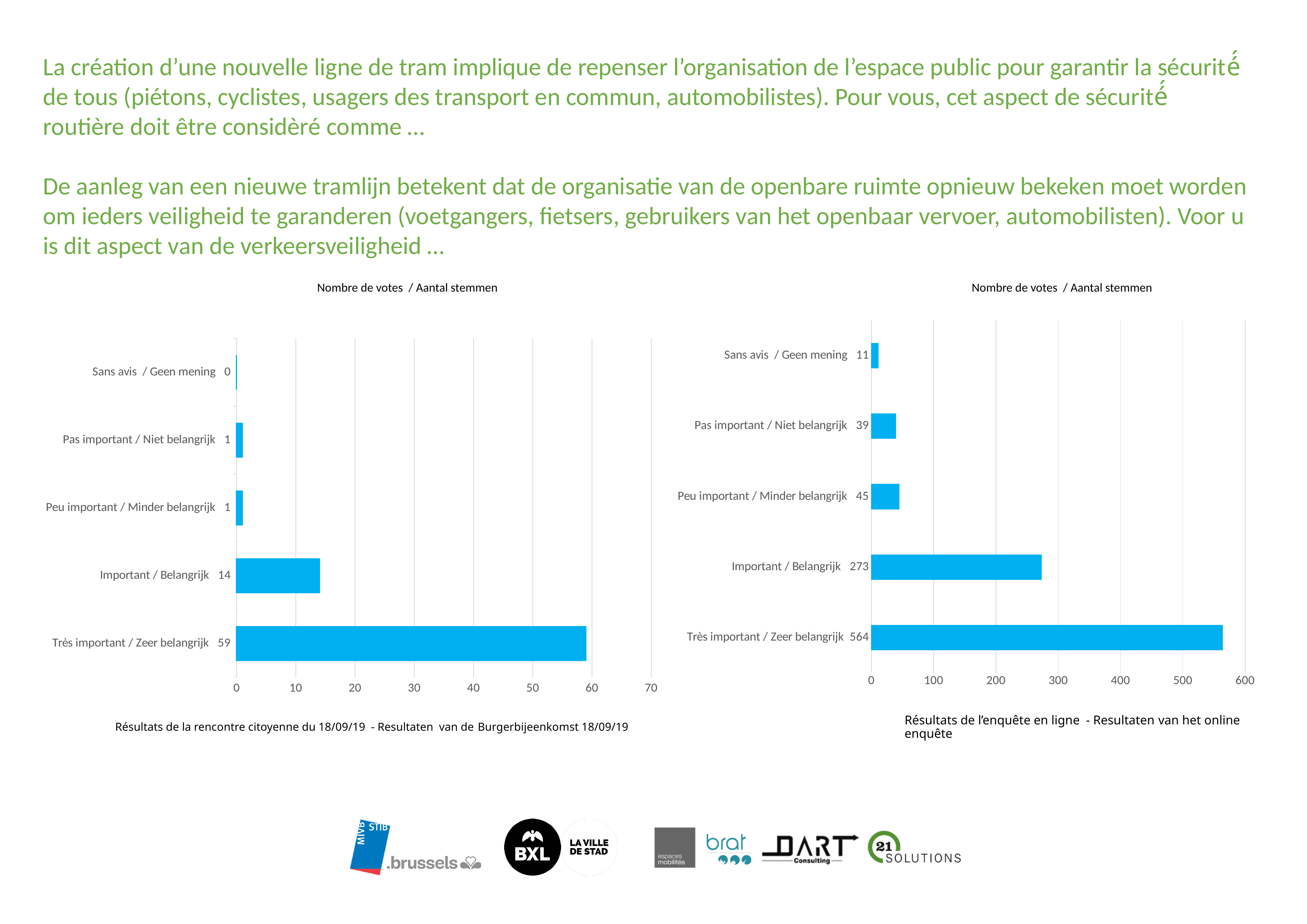
In the right chart (Résultats de l'enquête en ligne), what is the difference in votes between 'Très important / Zeer belangrijk' and 'Important / Belangrijk'? 291 In the right chart (Résultats de l'enquête en ligne), which category has the highest number of votes? Très important / Zeer belangrijk In the left chart (Résultats de la rencontre citoyenne du 18/09/19), how many categories are shown? 5 What type of chart is used on the right side of the slide (Résultats de l'enquête en ligne)? Bar chart In the right chart (Résultats de l'enquête en ligne), how many votes did 'Très important / Zeer belangrijk' receive? 564 In the right chart (Résultats de l'enquête en ligne), how many votes did 'Pas important / Niet belangrijk' receive? 39 In the left chart (Résultats de la rencontre citoyenne du 18/09/19), which category has the lowest number of votes? Sans avis / Geen mening In the left chart (Résultats de la rencontre citoyenne du 18/09/19), what is the difference in votes between 'Très important / Zeer belangrijk' and 'Important / Belangrijk'? 45 In the left chart (Résultats de la rencontre citoyenne du 18/09/19), how many votes did 'Important / Belangrijk' receive? 14 In the left chart (Résultats de la rencontre citoyenne du 18/09/19), how many votes did 'Très important / Zeer belangrijk' receive? 59 In the right chart (Résultats de l'enquête en ligne), which category has the lowest number of votes? Sans avis / Geen mening In the right chart (Résultats de l'enquête en ligne), which has more votes: 'Peu important / Minder belangrijk' or 'Pas important / Niet belangrijk'? Peu important / Minder belangrijk